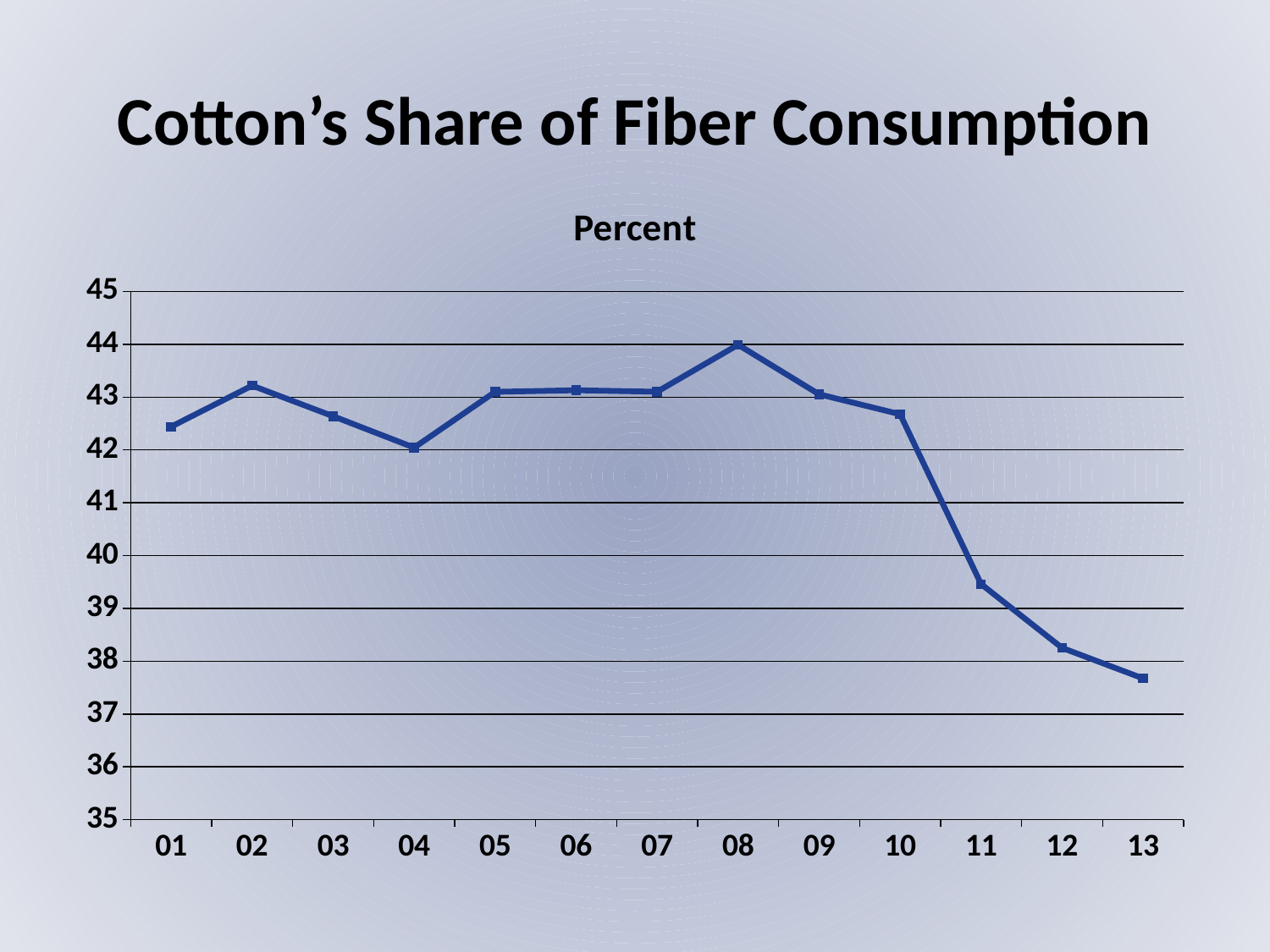
Which year has the larger value, 02 or 04? 02 Is the value for 08 greater or less than 43? greater Do the values rise or fall from 10 to 13? fall How many years are plotted along the x axis? 13 What kind of chart is shown on the slide? line chart What is the title of the chart on the slide? Cotton's Share of Fiber Consumption In which year is cotton's share of fiber consumption highest? 08 Is the value for 13 greater or less than 38? less In which year is cotton's share of fiber consumption lowest? 13 What unit label appears above the chart's plot area? Percent Is the value for 10 greater or less than 42? greater